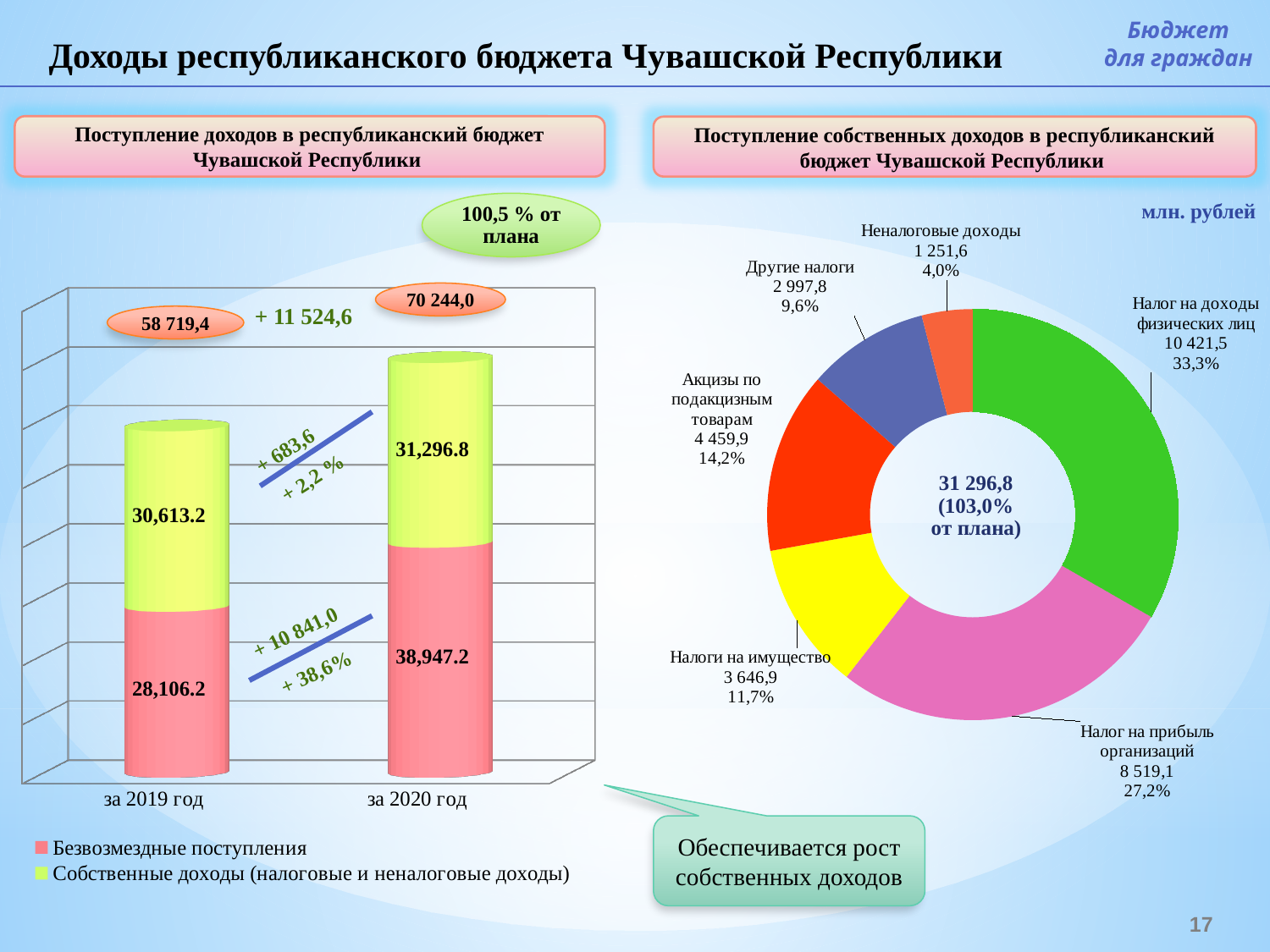
On the left chart, what is the total of the stacked bar for за 2020 год? 70 244,0 On the left chart, what kind of chart is shown? Stacked bar chart On the left chart, how many series does the legend list? 2 On the left chart (Поступление доходов в республиканский бюджет Чувашской Республики), what is the value of Безвозмездные поступления for за 2020 год? 38,947.2 On the left chart, which is larger for за 2020 год: Безвозмездные поступления or Собственные доходы? Безвозмездные поступления On the left chart, what is the total of the stacked bar for за 2019 год? 58 719,4 On the right chart, how many categories are shown? 6 On the right chart (Поступление собственных доходов в республиканский бюджет Чувашской Республики), what is the value for Налог на прибыль организаций? 8 519,1 On the right chart, which category has the smallest share? Неналоговые доходы On the right chart, which category has the largest share? Налог на доходы физических лиц On the left chart, what is the value of Собственные доходы for за 2019 год? 30,613.2 On the right chart, what share of the total do Акцизы по подакцизным товарам represent? 14,2%